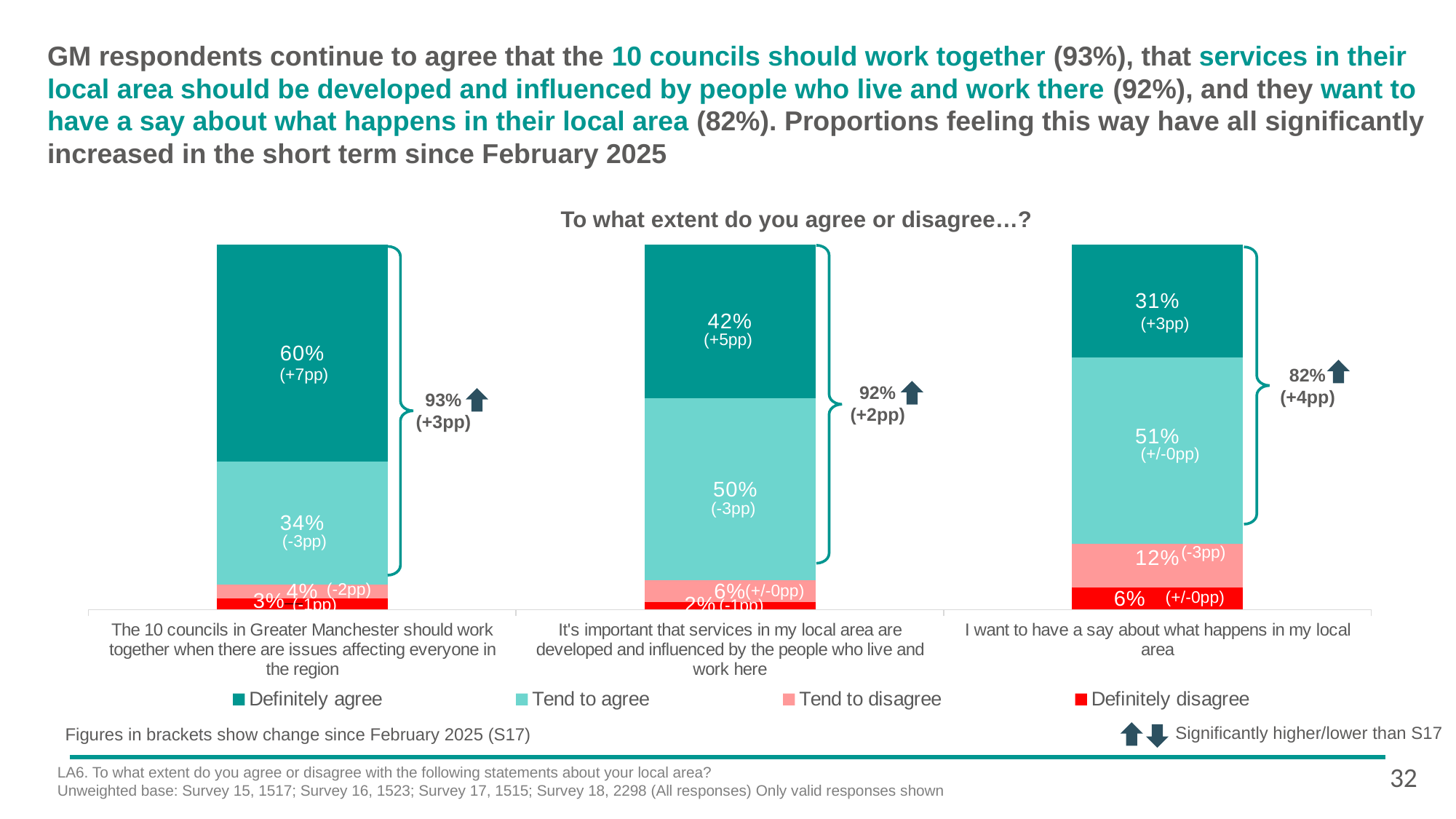
What percentage tend to agree that it's important that services in their local area are developed and influenced by the people who live and work there? 50% Which statement has the lowest 'Definitely disagree' percentage? It's important that services in my local area are developed and influenced by the people who live and work here What percentage of respondents definitely agree that the 10 councils in Greater Manchester should work together? 60% What kind of chart is shown on the slide? Stacked bar chart What is the change since February 2025 shown for the 'Definitely agree' share of the councils working together statement? +7pp Is the 'Tend to agree' percentage larger for the services statement or for the councils working together statement? The services statement How many statements (categories) are plotted on the chart? 3 How many series does the legend list? 4 What is the difference between the 'Definitely agree' percentages for the councils working together statement and the wanting a say statement? 29 percentage points Which statement has the highest 'Definitely agree' percentage? The 10 councils in Greater Manchester should work together when there are issues affecting everyone in the region What is the combined agree percentage (definitely agree plus tend to agree) shown for 'I want to have a say about what happens in my local area'? 82% What percentage tend to disagree with the statement 'I want to have a say about what happens in my local area'? 12%